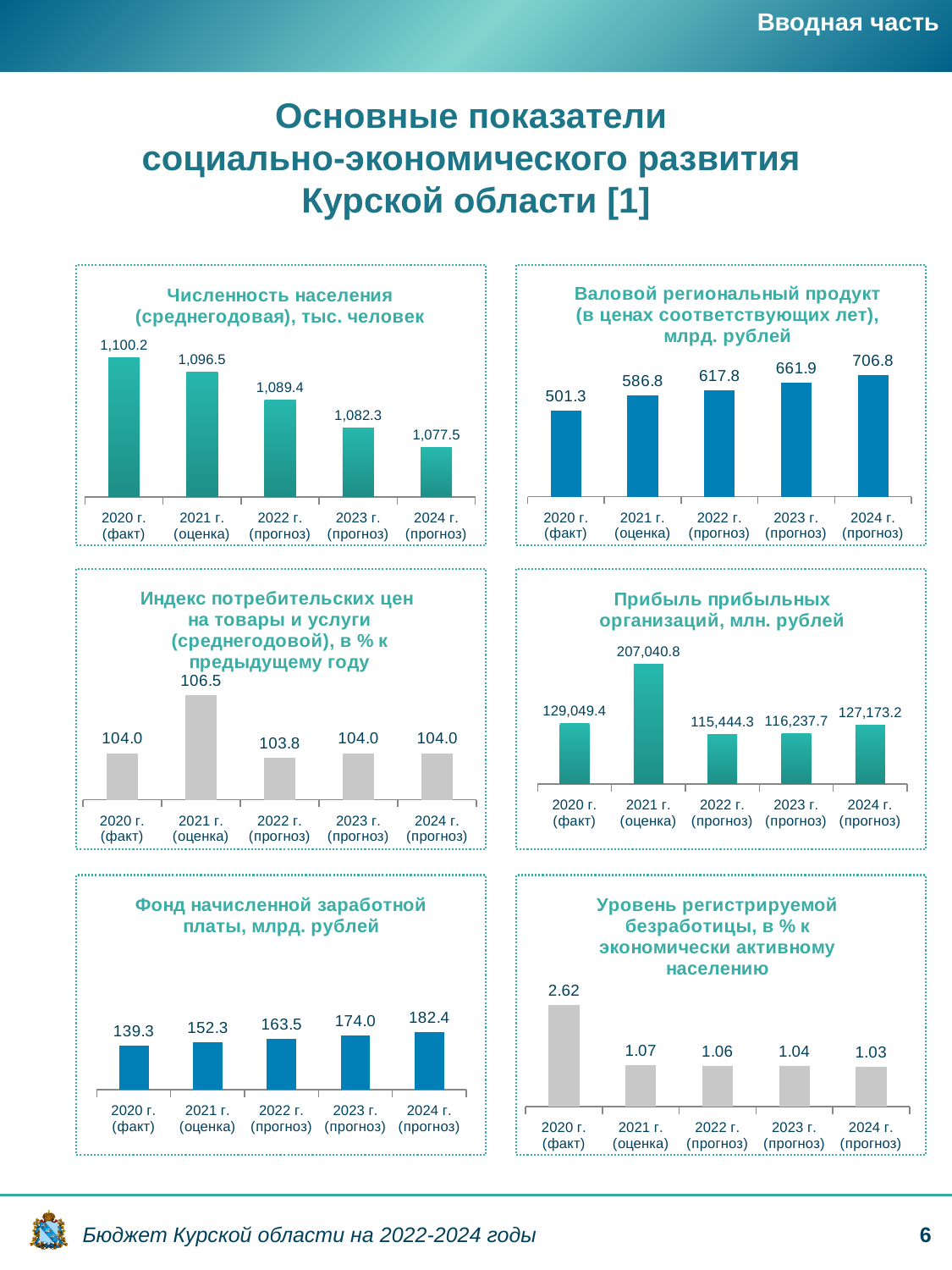
In the chart "Численность населения (среднегодовая), тыс. человек", do the values rise or fall from 2020 to 2024? fall In the chart "Численность населения (среднегодовая), тыс. человек", what is the value for 2021 г. (оценка)? 1,096.5 In the chart "Валовой региональный продукт (в ценах соответствующих лет), млрд. рублей", which year has the highest value? 2024 г. (прогноз) In the chart "Фонд начисленной заработной платы, млрд. рублей", how many bars are plotted? 5 In the chart "Валовой региональный продукт (в ценах соответствующих лет), млрд. рублей", what is the difference between the 2024 г. (прогноз) and 2020 г. (факт) values? 205.5 In the chart "Прибыль прибыльных организаций, млн. рублей", which is larger: the value for 2020 г. (факт) or 2024 г. (прогноз)? 2020 г. (факт) In the chart "Прибыль прибыльных организаций, млн. рублей", what is the value for 2021 г. (оценка)? 207,040.8 In the chart "Фонд начисленной заработной платы, млрд. рублей", what is the value for 2023 г. (прогноз)? 174.0 In the chart "Индекс потребительских цен на товары и услуги (среднегодовой), в % к предыдущему году", which year has the lowest value? 2022 г. (прогноз) What type of chart is "Уровень регистрируемой безработицы, в % к экономически активному населению"? bar chart In the chart "Уровень регистрируемой безработицы, в % к экономически активному населению", what is the value for 2020 г. (факт)? 2.62 In the chart "Индекс потребительских цен на товары и услуги (среднегодовой), в % к предыдущему году", what is the value for 2021 г. (оценка)? 106.5